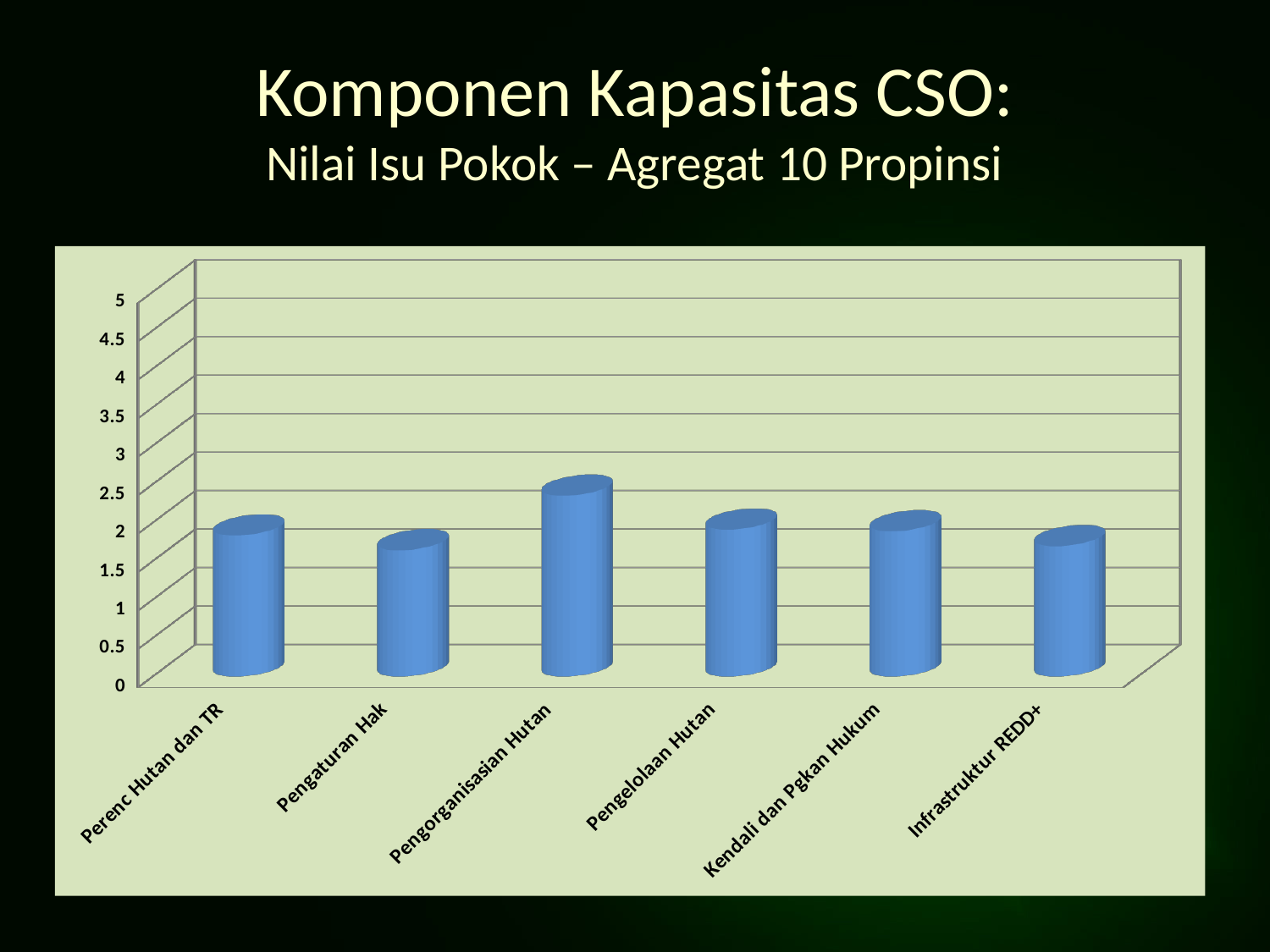
What kind of chart is shown on the slide? bar chart Is the value for Pengaturan Hak greater or less than 2? less Which category has the highest value? Pengorganisasian Hutan What is the highest value shown on the vertical axis? 5 Is the value for Pengorganisasian Hutan greater or less than 3? less Which is larger, the value for Pengorganisasian Hutan or the value for Pengaturan Hak? Pengorganisasian Hutan Which is larger, the value for Pengorganisasian Hutan or the value for Infrastruktur REDD+? Pengorganisasian Hutan Is the value for Pengelolaan Hutan greater or less than 2.5? less How many categories are plotted on the chart? 6 What is the title of the slide containing the chart? Komponen Kapasitas CSO: Nilai Isu Pokok – Agregat 10 Propinsi